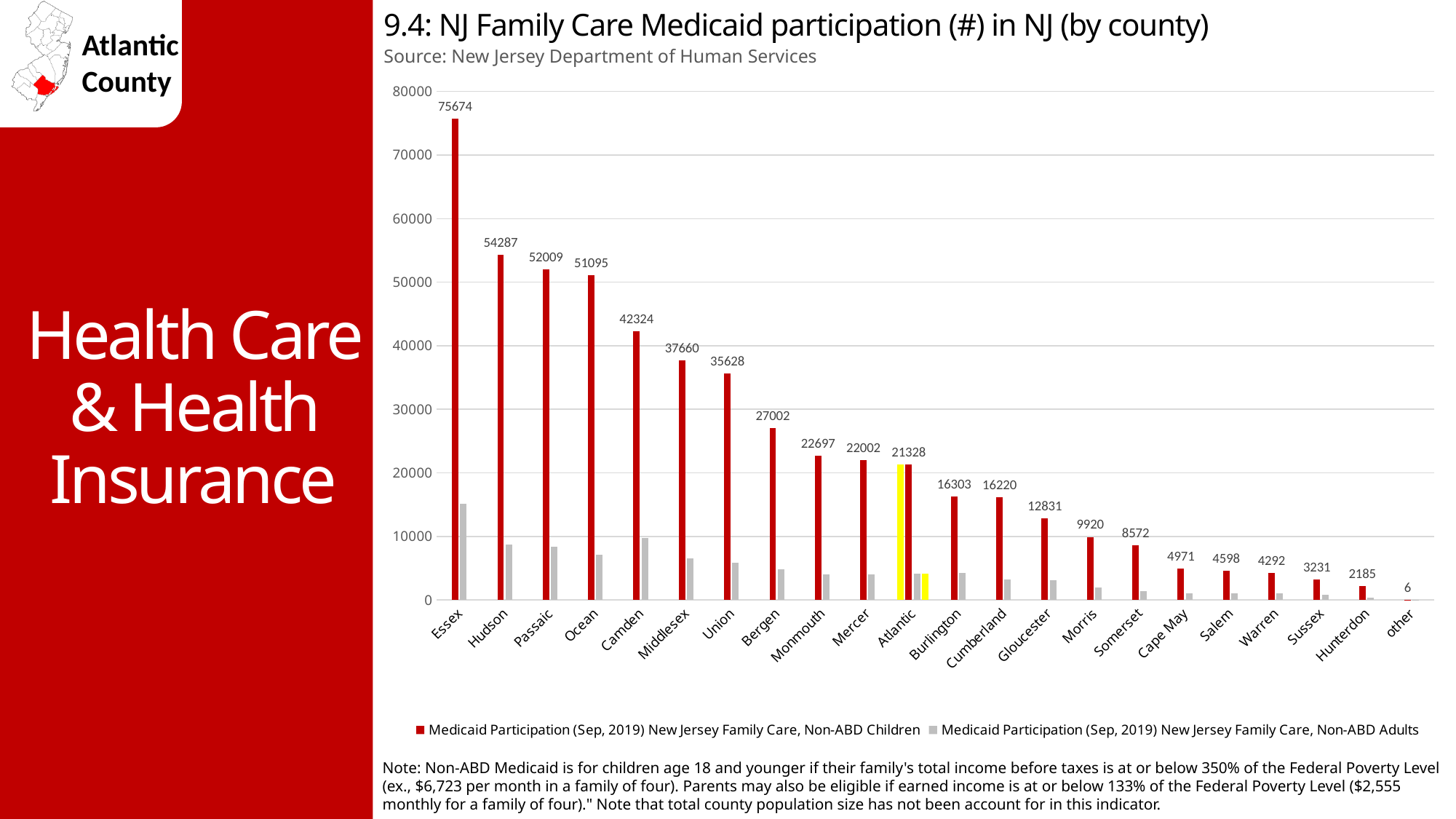
Which has a larger Non-ABD Children value, Burlington or Cumberland? Burlington What is the Non-ABD Children Medicaid participation value for Atlantic? 21328 What is the Non-ABD Children Medicaid participation value for Essex? 75674 What kind of chart is shown on the slide? Bar chart What is the source cited for the chart? New Jersey Department of Human Services What is the Non-ABD Children Medicaid participation value for Cape May? 4971 Which county has the highest Non-ABD Children Medicaid participation? Essex What is the difference between the Non-ABD Children values for Hudson and Passaic? 2278 Which county (excluding 'other') has the lowest Non-ABD Children Medicaid participation? Hunterdon How many series does the legend list? 2 How many categories are shown on the x axis? 22 Is the Non-ABD Adults value for Essex greater or less than 10000? greater